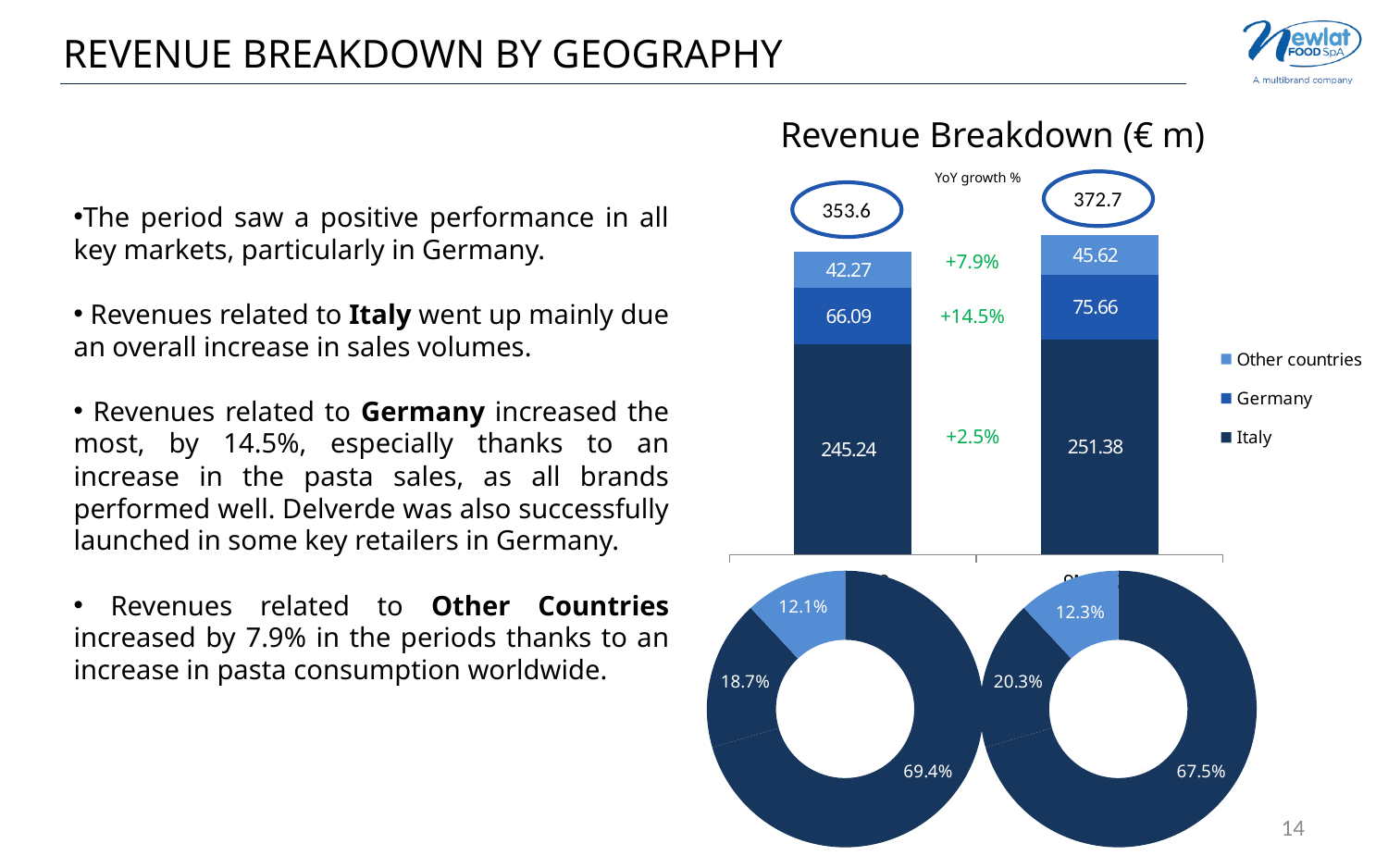
In the Revenue Breakdown (€ m) stacked bar chart, what is the difference between the Italy values of the right bar and the left bar? 6.14 In the Revenue Breakdown (€ m) stacked bar chart, what YoY growth % is shown for Germany? +14.5% In the Revenue Breakdown (€ m) stacked bar chart, which series has the largest value in the right bar? Italy In the Revenue Breakdown (€ m) stacked bar chart, what is the Other countries value in the left bar? 42.27 In the Revenue Breakdown (€ m) stacked bar chart, what is the total shown above the left bar? 353.6 In the right donut chart, what share is shown for the smallest slice? 12.3% In the Revenue Breakdown (€ m) stacked bar chart, what is the Italy value in the left bar? 245.24 In the Revenue Breakdown (€ m) stacked bar chart, what is the Germany value in the right bar? 75.66 How many series does the legend of the Revenue Breakdown (€ m) chart list? 3 In the Revenue Breakdown (€ m) stacked bar chart, what YoY growth % is shown for Italy? +2.5% In the left donut chart, what share is shown for the largest slice? 69.4% In the Revenue Breakdown (€ m) stacked bar chart, what is the total shown above the right bar? 372.7